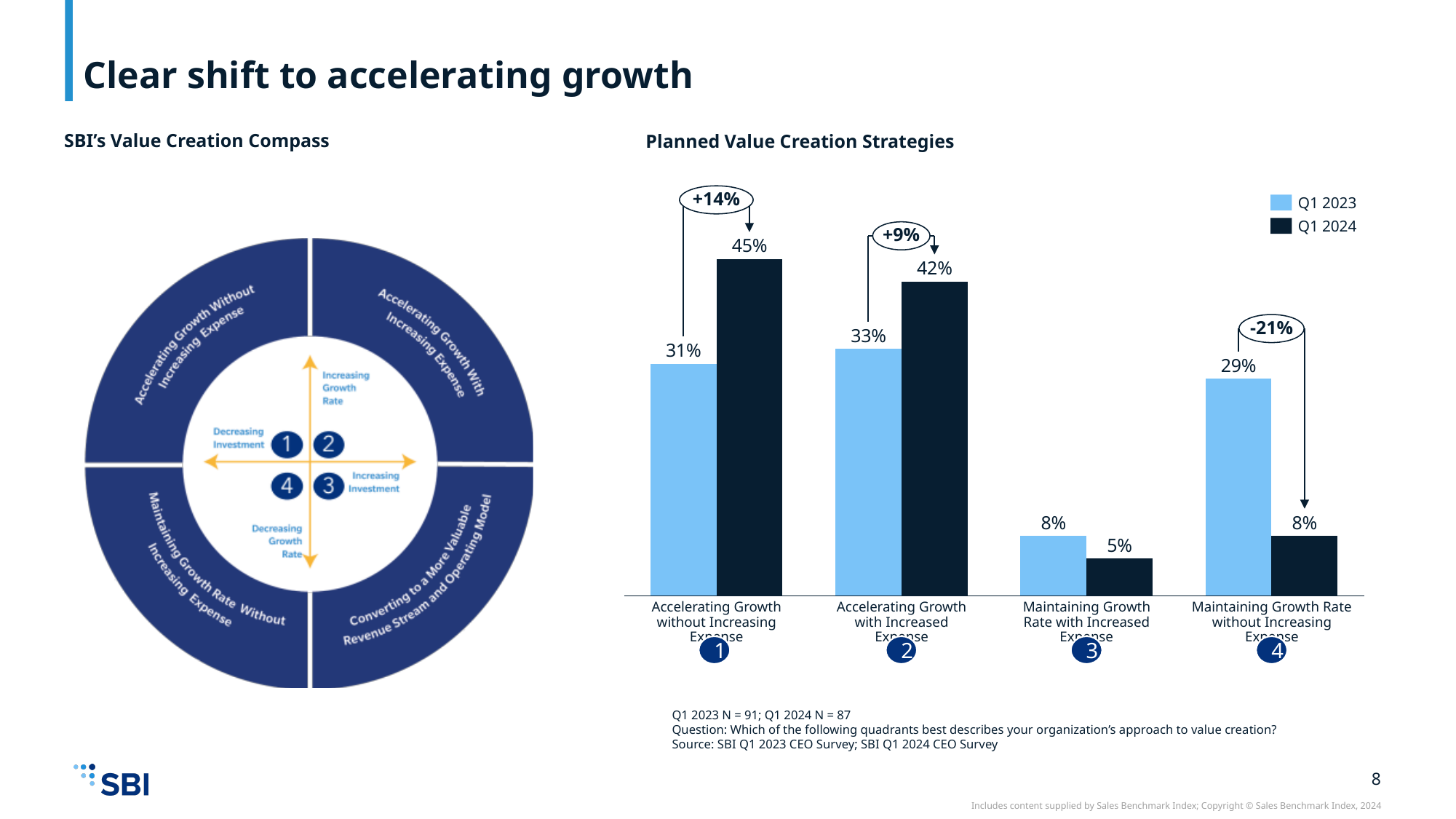
How many series does the legend of the Planned Value Creation Strategies chart list? 2 In the Planned Value Creation Strategies chart, what is the Q1 2024 value for Accelerating Growth without Increasing Expense? 45% What kind of chart is the Planned Value Creation Strategies chart? Bar chart How many categories are shown on the x axis of the Planned Value Creation Strategies chart? 4 In the Planned Value Creation Strategies chart, which is larger for Accelerating Growth without Increasing Expense: Q1 2023 or Q1 2024? Q1 2024 In the Planned Value Creation Strategies chart, what is the difference between the Q1 2024 and Q1 2023 values for Accelerating Growth with Increased Expense? 9% In the Planned Value Creation Strategies chart, what is the Q1 2024 value for Maintaining Growth Rate with Increased Expense? 5% In the Planned Value Creation Strategies chart, what is the Q1 2023 value for Maintaining Growth Rate without Increasing Expense? 29% In the Planned Value Creation Strategies chart, which series is shown in light blue? Q1 2023 In the Planned Value Creation Strategies chart, what is the difference between the Q1 2023 and Q1 2024 values for Maintaining Growth Rate without Increasing Expense? 21% In the Planned Value Creation Strategies chart, which category has the highest Q1 2024 value? Accelerating Growth without Increasing Expense In the Planned Value Creation Strategies chart, which category has the lowest Q1 2023 value? Maintaining Growth Rate with Increased Expense